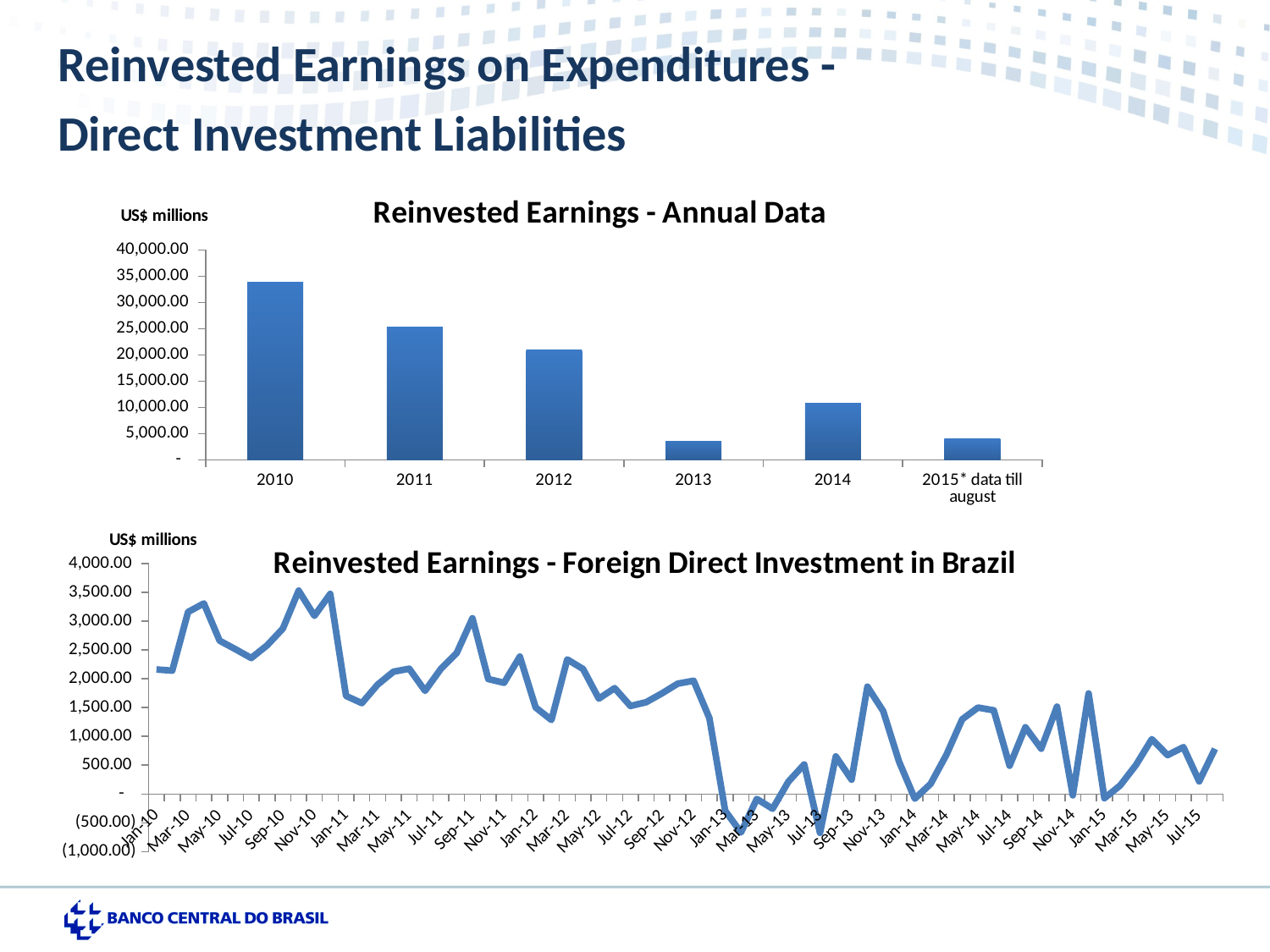
In the top chart 'Reinvested Earnings - Annual Data', is the value for 2013 greater or less than 5,000.00? less What kind of chart is the top chart, 'Reinvested Earnings - Annual Data'? bar chart In the top chart 'Reinvested Earnings - Annual Data', which year has the highest value? 2010 In the top chart 'Reinvested Earnings - Annual Data', do the values rise or fall from 2010 to 2013? fall What kind of chart is the bottom chart, 'Reinvested Earnings - Foreign Direct Investment in Brazil'? line chart How many categories are shown on the x axis of the top chart 'Reinvested Earnings - Annual Data'? 6 In the top chart 'Reinvested Earnings - Annual Data', which is larger, the value for 2013 or the value for 2014? 2014 In the top chart 'Reinvested Earnings - Annual Data', is the value for 2010 greater or less than 30,000.00? greater In the top chart 'Reinvested Earnings - Annual Data', is the value for 2014 greater or less than 15,000.00? less In the top chart 'Reinvested Earnings - Annual Data', which is larger, the value for 2011 or the value for 2012? 2011 What unit is shown on the y axis of the bottom chart 'Reinvested Earnings - Foreign Direct Investment in Brazil'? US$ millions